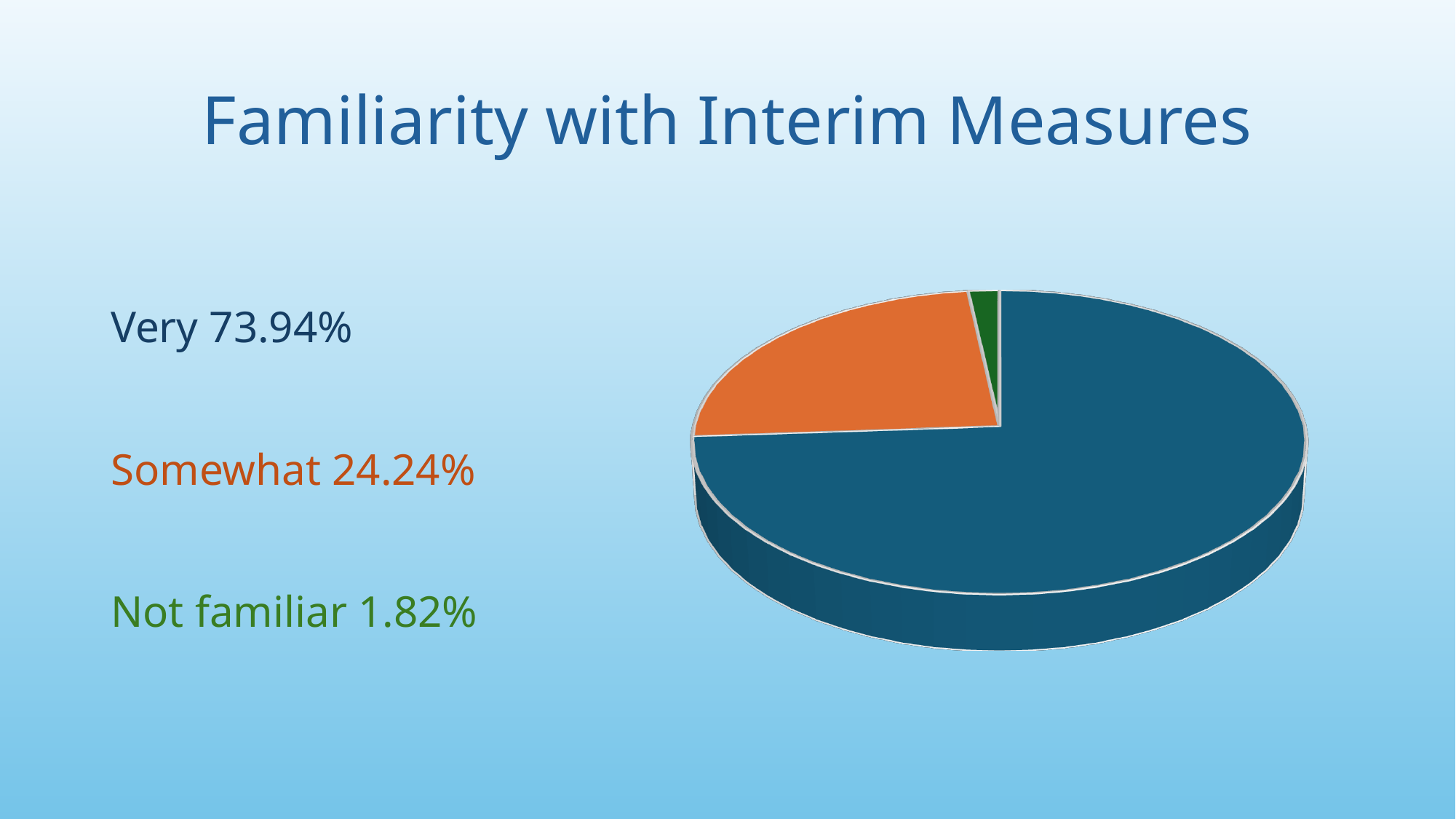
What kind of chart is shown on the slide? Pie chart Which category has the largest share of the pie? Very What share of respondents are Not familiar with interim measures? 1.82% What is the difference in percentage points between the Somewhat and Not familiar shares? 22.42 What colour is the slice for the Somewhat category? Orange What is the title of the slide? Familiarity with Interim Measures What share of respondents are Very familiar with interim measures? 73.94% What is the difference in percentage points between the Very and Somewhat shares? 49.7 Which category has the smallest share of the pie? Not familiar How many categories does the pie chart show? 3 What share of respondents are Somewhat familiar with interim measures? 24.24% Which is larger, the Somewhat share or the Not familiar share? Somewhat